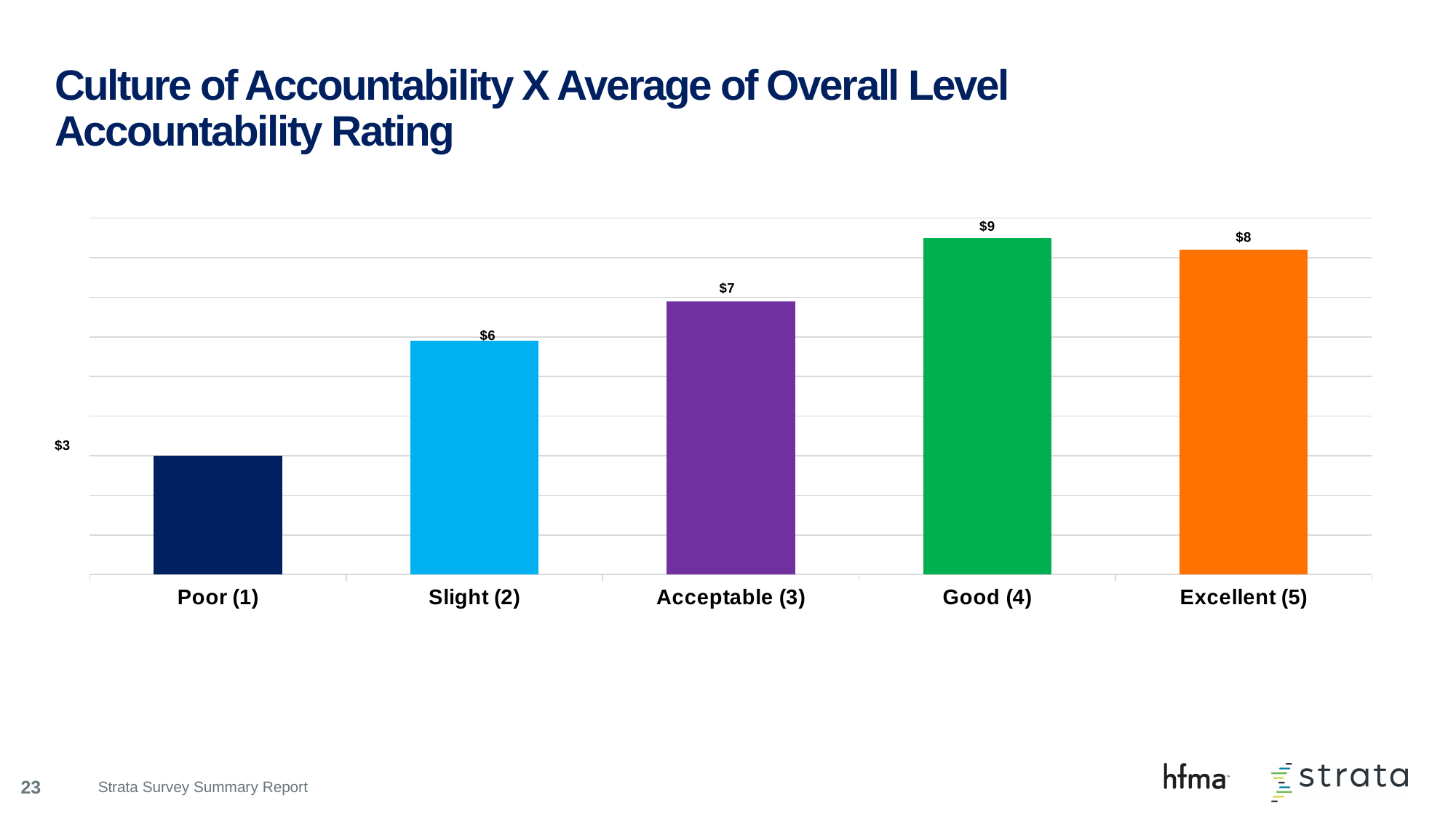
What is the difference between the values for Good (4) and Poor (1)? $6 What is the value for Slight (2)? $6 What is the value for Poor (1)? $3 Which is larger, the value for Excellent (5) or the value for Acceptable (3)? Excellent (5) Which category has the lowest value? Poor (1) What is the title of the chart on this slide? Culture of Accountability X Average of Overall Level Accountability Rating What is the value for Good (4)? $9 What is the value for Acceptable (3)? $7 What kind of chart is this? Bar chart Which category has the highest value? Good (4) How many categories are shown on the x axis? 5 What is the value for Excellent (5)? $8